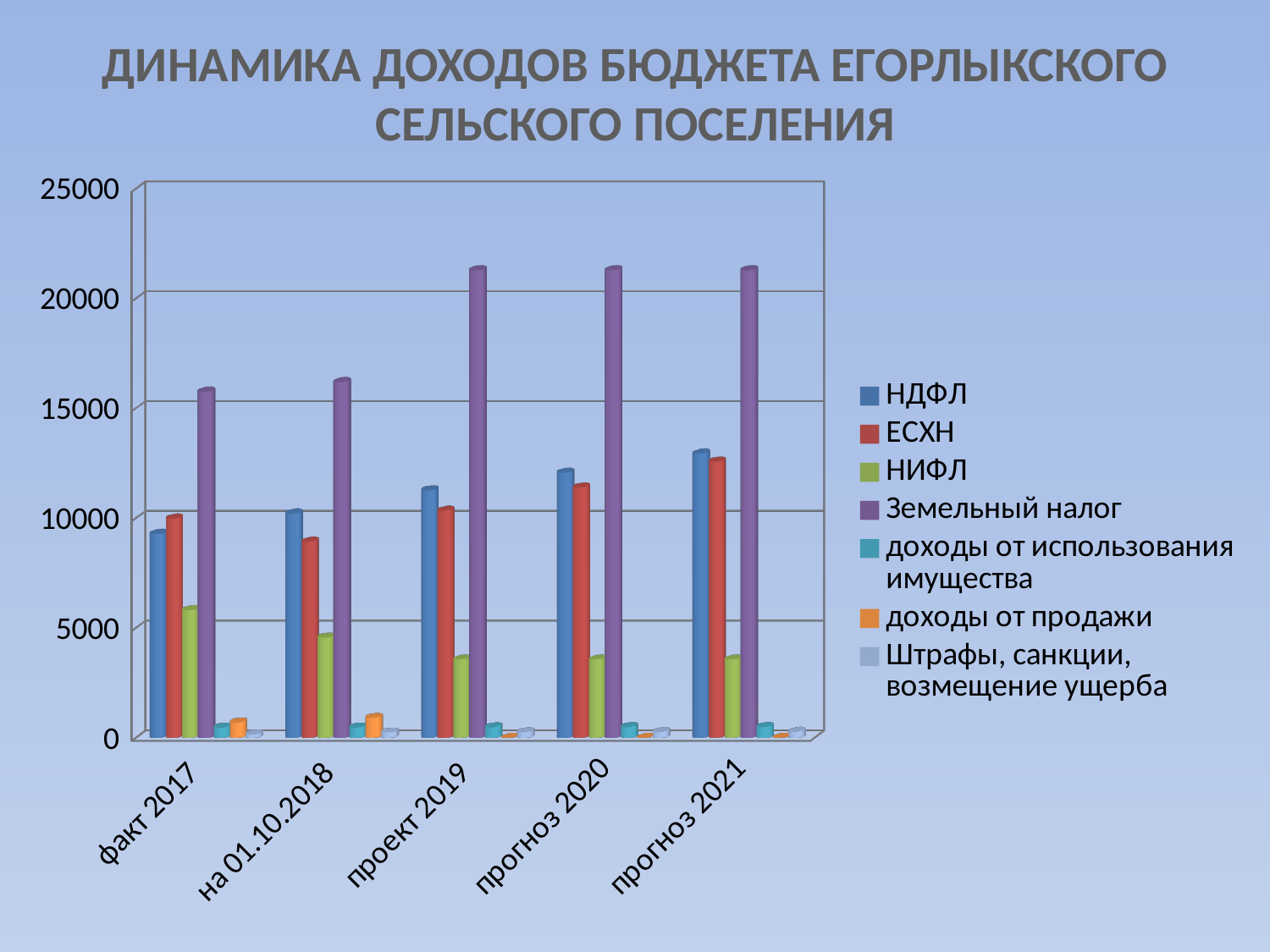
Is the value of ЕСХН for прогноз 2021 greater or less than 10000? greater How many series does the legend list? 7 Is the value of Земельный налог for проект 2019 greater or less than 20000? greater How many categories are shown along the x axis? 5 Is the value of НДФЛ for факт 2017 greater or less than 10000? less Which series has the highest value in the прогноз 2021 category? Земельный налог What is the title of the chart on the slide? ДИНАМИКА ДОХОДОВ БЮДЖЕТА ЕГОРЛЫКСКОГО СЕЛЬСКОГО ПОСЕЛЕНИЯ What kind of chart is shown on the slide? bar chart Which is larger in the факт 2017 category: НДФЛ or НИФЛ? НДФЛ Does the value of НДФЛ rise or fall from факт 2017 to прогноз 2021? rise Which series has the lowest value in the факт 2017 category? Штрафы, санкции, возмещение ущерба